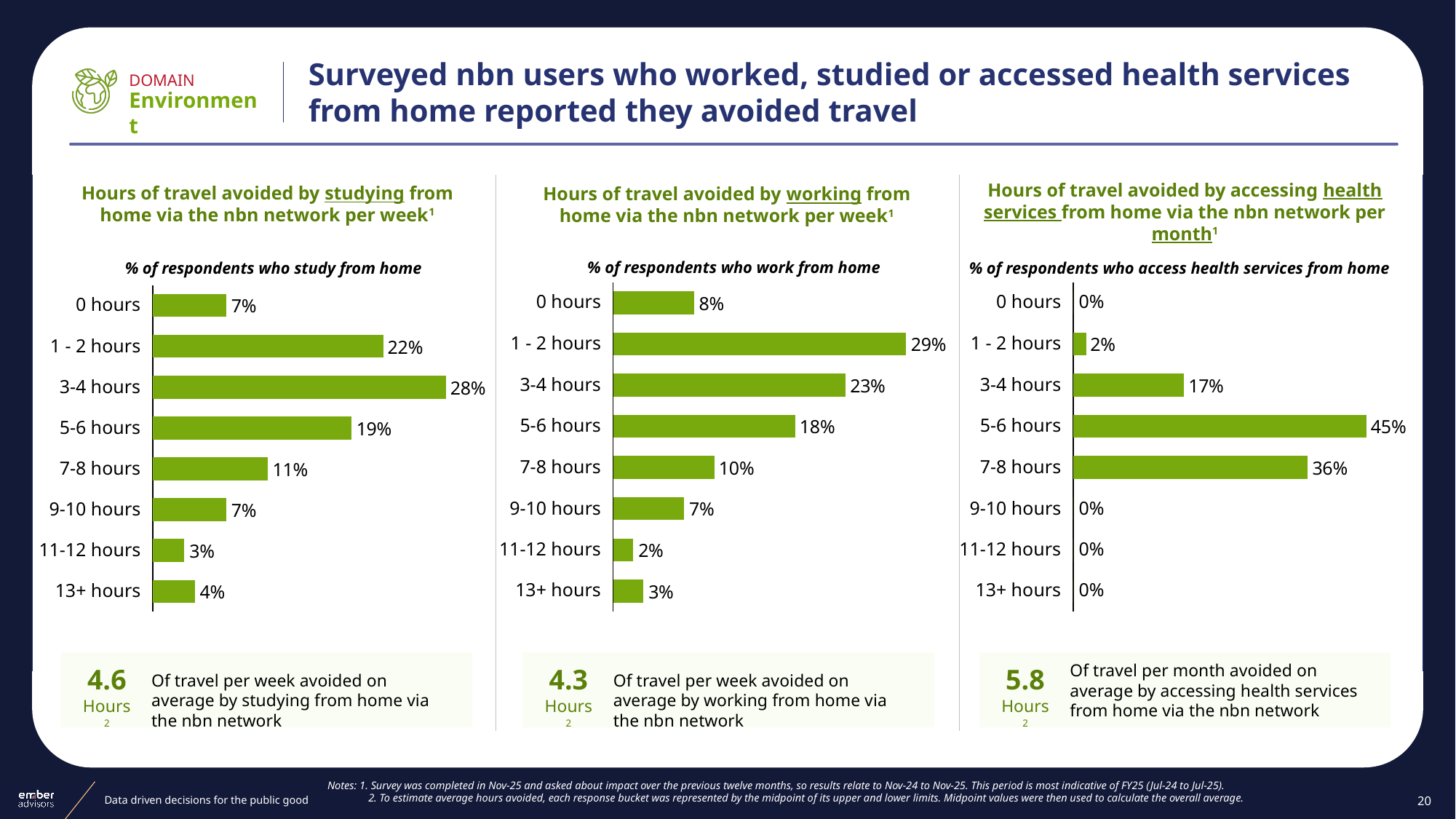
In the 'Hours of travel avoided by working from home' chart, what percentage of respondents avoided 1 - 2 hours of travel? 29% In the 'Hours of travel avoided by working from home' chart, what percentage of respondents avoided 13+ hours of travel? 3% According to the slide, what is the average number of hours of travel per week avoided by working from home via the nbn network? 4.3 Hours What type of chart is used to show hours of travel avoided by studying from home? Bar chart In the 'Hours of travel avoided by accessing health services from home' chart, what percentage of respondents avoided 7-8 hours of travel? 36% In the 'Hours of travel avoided by studying from home' chart, what percentage of respondents avoided 3-4 hours of travel? 28% In the 'Hours of travel avoided by accessing health services from home' chart, how many categories show 0%? 4 In the 'Hours of travel avoided by studying from home' chart, which is larger: the value for 5-6 hours or the value for 7-8 hours? 5-6 hours In the 'Hours of travel avoided by accessing health services from home' chart, which category has the highest percentage? 5-6 hours In the 'Hours of travel avoided by studying from home' chart, which category has the lowest percentage? 11-12 hours In the 'Hours of travel avoided by working from home' chart, what is the difference between the 1 - 2 hours and 3-4 hours percentages? 6% How many categories are shown in the 'Hours of travel avoided by working from home' chart? 8